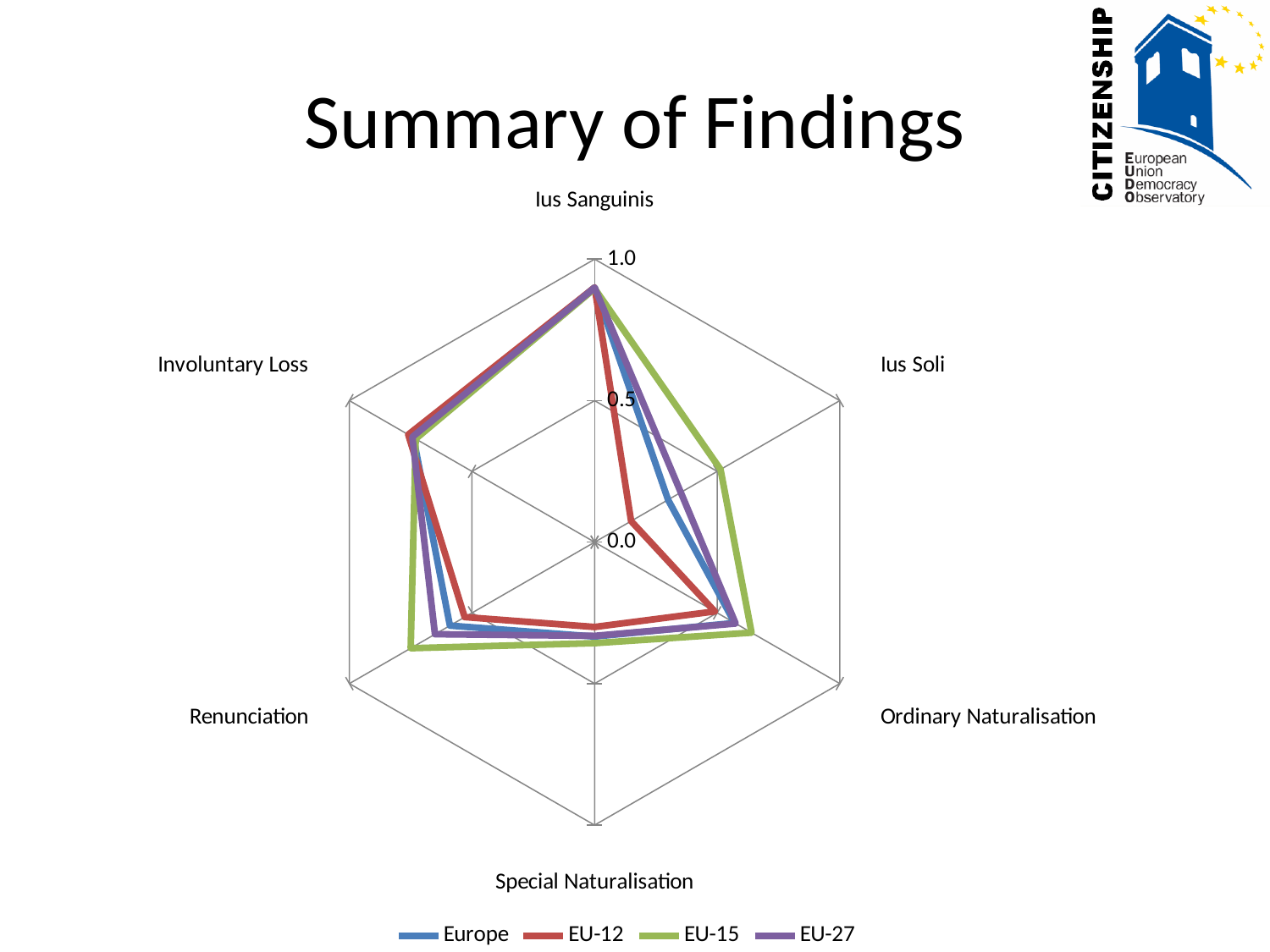
On Renunciation, which is larger: the value for EU-15 or the value for EU-12? EU-15 Which series is drawn in green in the chart? EU-15 Which series has the highest value on Ius Soli? EU-15 How many series does the legend list? 4 Which series has the lowest value on Ius Soli? EU-12 Is the value for Europe on Ius Sanguinis greater or less than 0.5? greater What is the title of the slide containing the chart? Summary of Findings Is the value for EU-12 on Ius Soli greater or less than 0.5? less How many categories (axes) does the radar chart have? 6 Is the value for EU-27 on Special Naturalisation greater or less than 0.5? less What kind of chart is shown on the slide? Radar chart